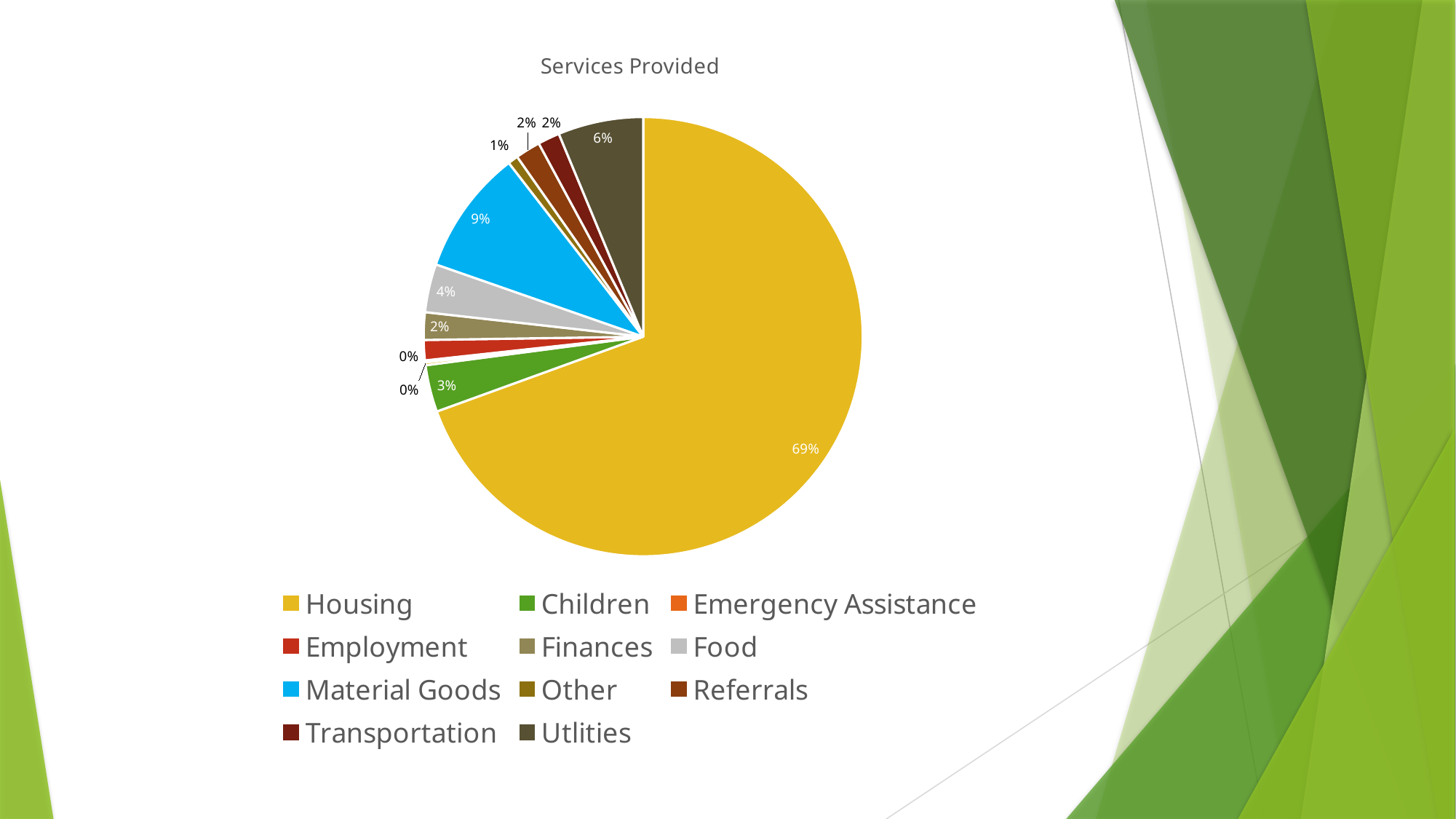
How many percentage points larger is the Housing share than the Material Goods share? 60% What kind of chart is shown on the slide? pie chart What percentage is shown for Material Goods? 9% How many categories does the legend of the pie chart list? 11 Which category has the largest share of the pie? Housing What percentage is shown for Utlities? 6% What is the title of the chart? Services Provided What percentage is shown for Food? 4% What percentage is shown for Children? 3% Which has the larger share, Material Goods or Utlities? Material Goods What share of the pie does Housing account for? 69% What percentage is shown for Other? 1%